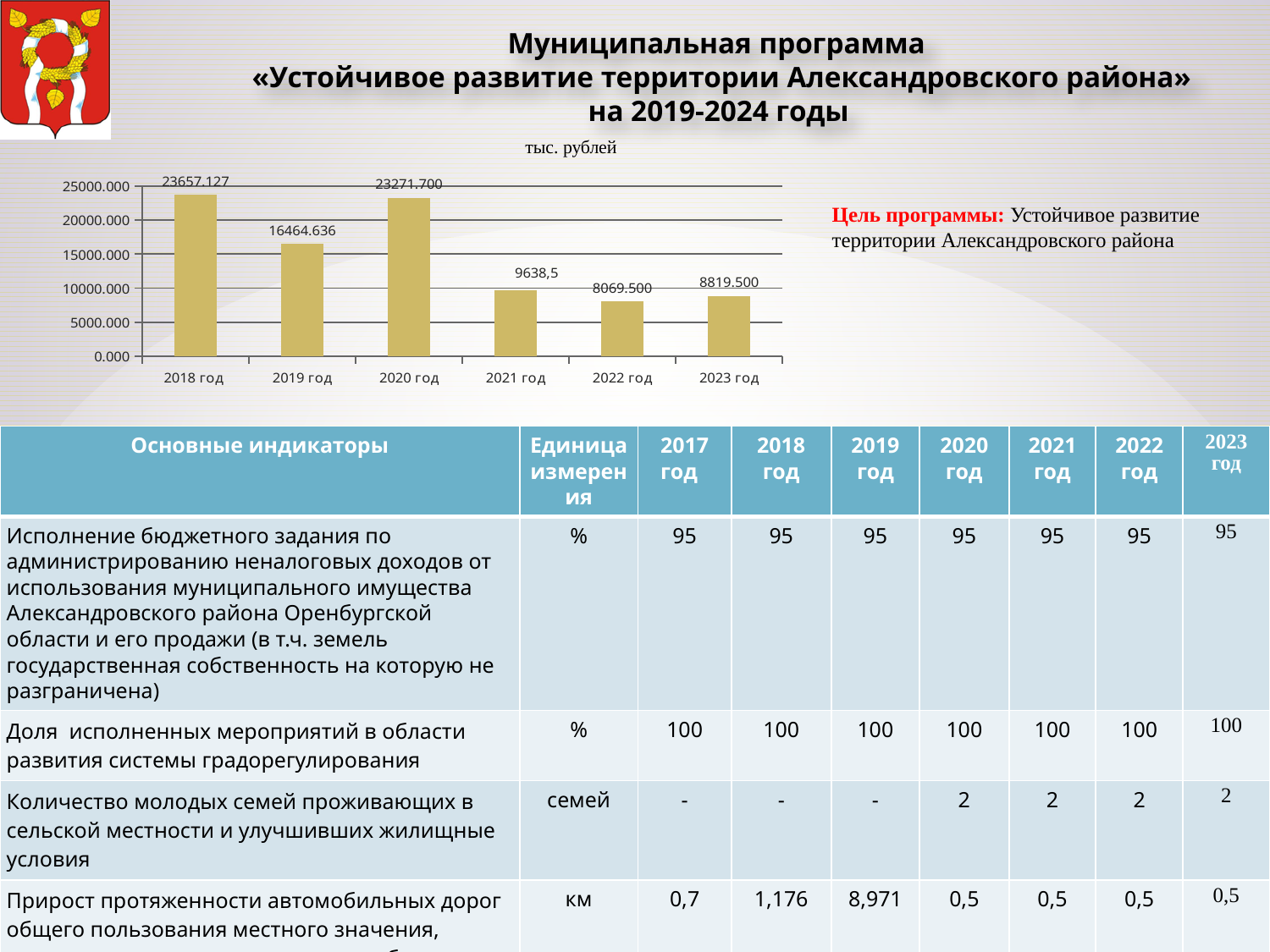
Is the value for 2021 год greater or less than 10000.000? less What is the difference between the values for 2023 год and 2022 год on the bar chart? 750.000 What kind of chart is shown on the slide? bar chart How many years are shown on the bar chart? 6 What is the value for 2021 год on the bar chart? 9638,5 What is the value for 2023 год on the bar chart? 8819.500 Which year has the lowest value on the bar chart? 2022 год What is the value for 2018 год on the bar chart? 23657.127 What unit of measurement is written above the bar chart? тыс. рублей Which is larger on the bar chart, the value for 2019 год or the value for 2020 год? 2020 год What is the value for 2019 год on the bar chart? 16464.636 Which year has the highest value on the bar chart? 2018 год